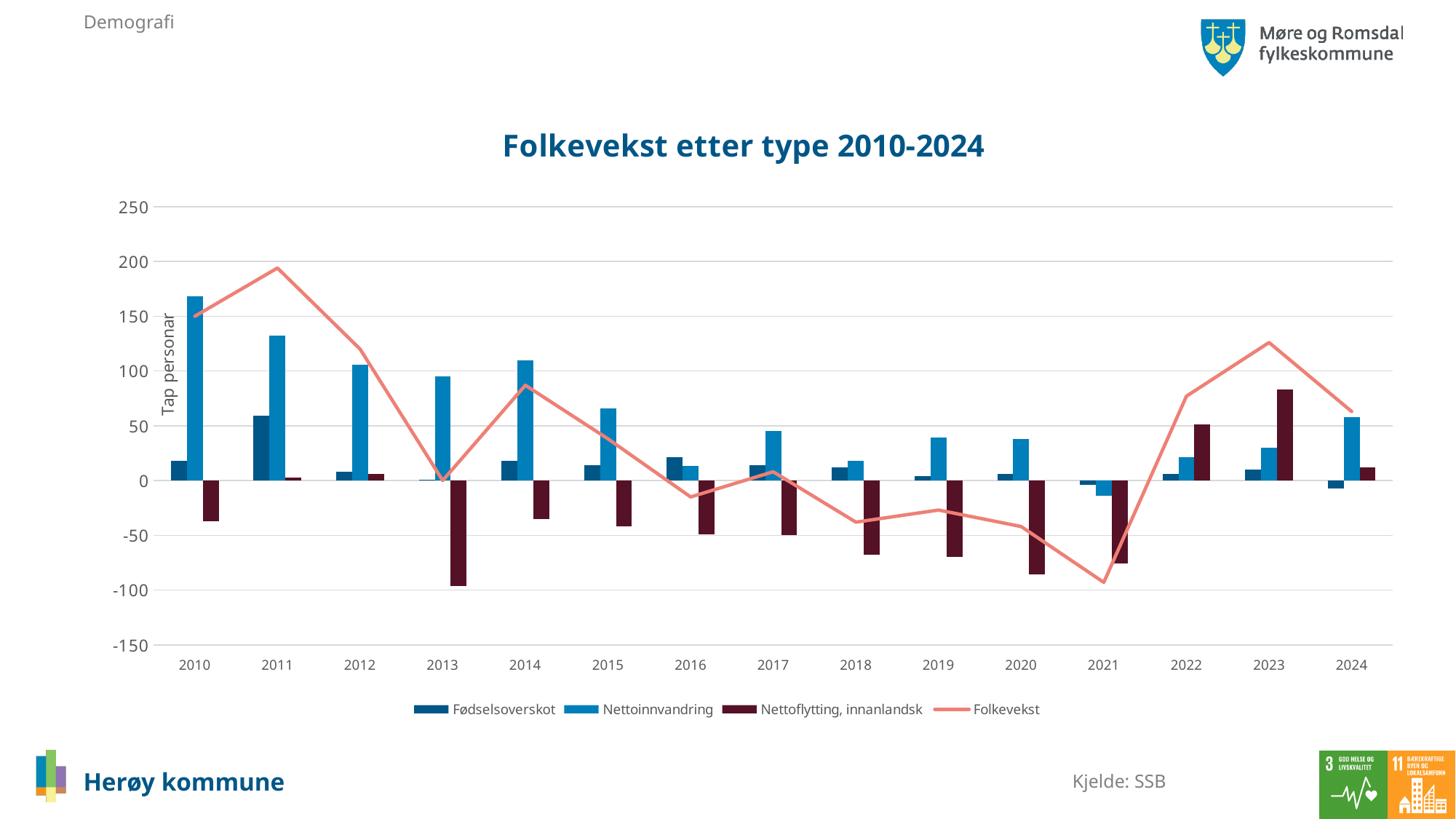
In which year is Fødselsoverskot highest? 2011 How many series does the legend list? 4 Is the value for Nettoflytting, innanlandsk in 2013 greater or less than -50? less In which year is Nettoinnvandring highest? 2010 In which year does the Folkevekst line reach its highest point? 2011 In which year does the Folkevekst line reach its lowest point? 2021 What kind of chart is shown on the slide? A bar chart combined with a line In which year is Nettoflytting, innanlandsk lowest? 2013 Does the Folkevekst line rise or fall from 2011 to 2013? fall How many years are shown on the x axis? 15 Is the value for Nettoinnvandring in 2010 greater or less than 150? greater Which year has the larger Nettoinnvandring value, 2011 or 2012? 2011